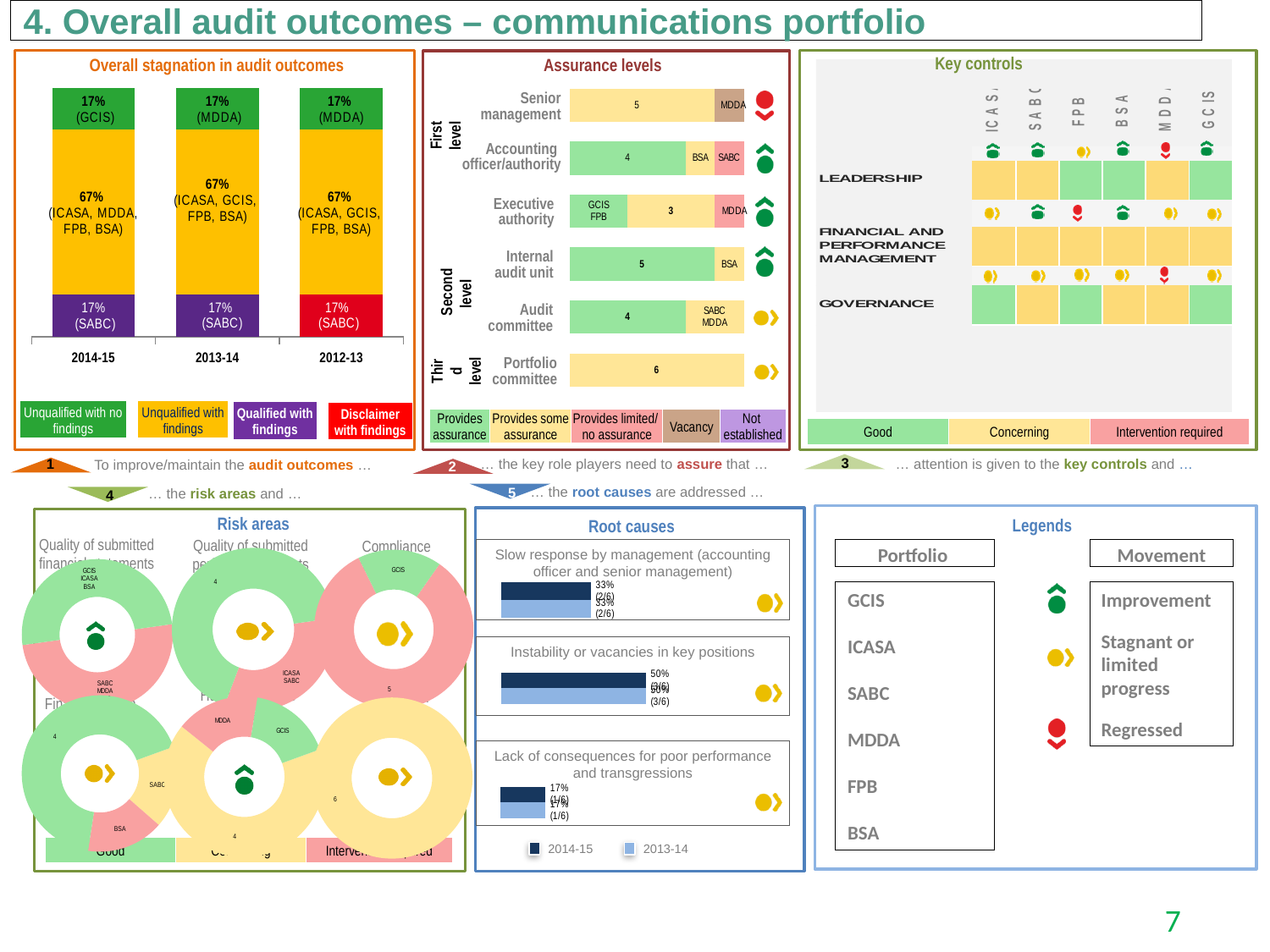
In the 'Assurance levels' chart, how many role players at senior management level provide some assurance? 5 In the 'Overall stagnation in audit outcomes' chart, how many financial years (bars) are shown? 3 In the 'Assurance levels' chart, how many internal audit units provide assurance? 5 In the 'Overall stagnation in audit outcomes' chart, what is the difference between the 'unqualified with findings' share and the 'unqualified with no findings' share in 2013-14? 50% In the 'Root causes' chart, what percentage is shown for 'Instability or vacancies in key positions' in 2014-15? 50% In the 'Overall stagnation in audit outcomes' chart, how many audit outcome categories does the legend list? 4 In the 'Assurance levels' chart, what value is shown for the portfolio committee? 6 In the 'Root causes' chart, how many series does the legend list? 2 In the 'Overall stagnation in audit outcomes' chart, which entity was unqualified with no findings in 2014-15? GCIS In the 'Overall stagnation in audit outcomes' chart, which entity received a disclaimer with findings in 2012-13? SABC In the 'Overall stagnation in audit outcomes' chart, what kind of chart is shown? Stacked bar chart In the 'Overall stagnation in audit outcomes' chart, what percentage of auditees were unqualified with findings in 2014-15? 67%